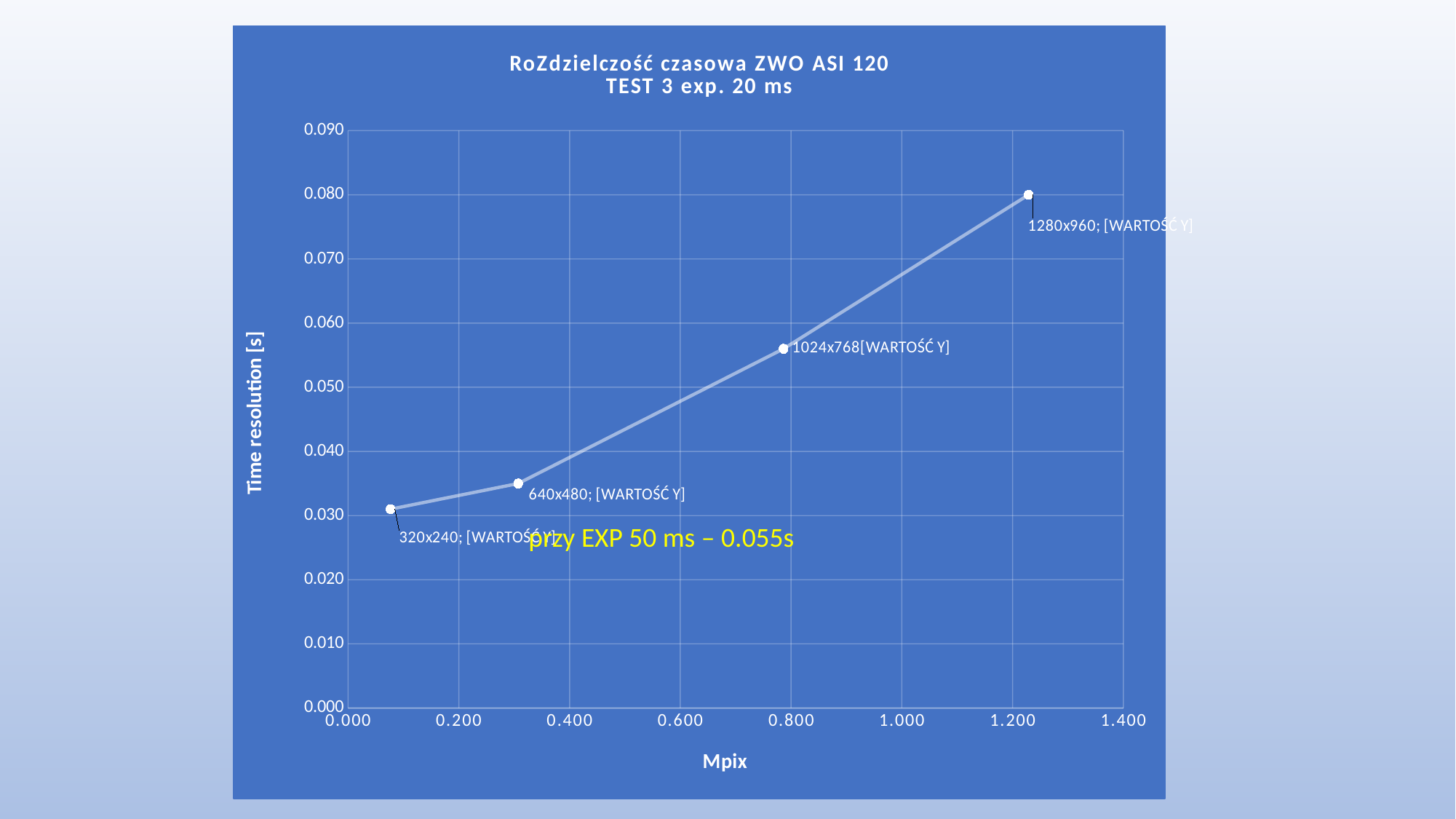
Is the time resolution value for 320x240 greater or less than 0.040? less What kind of chart is shown on the slide? line chart Do the values rise or fall as Mpix increases along the x axis? rise Which resolution has the lowest time resolution value? 320x240 What is the label of the x axis? Mpix Which resolution has the highest time resolution value? 1280x960 Is the time resolution value for 1024x768 greater or less than 0.050? greater What is the label of the y axis? Time resolution [s] How many data points are plotted on the chart? 4 Is the time resolution value for 640x480 greater or less than 0.040? less Which has a larger time resolution value, 640x480 or 1024x768? 1024x768